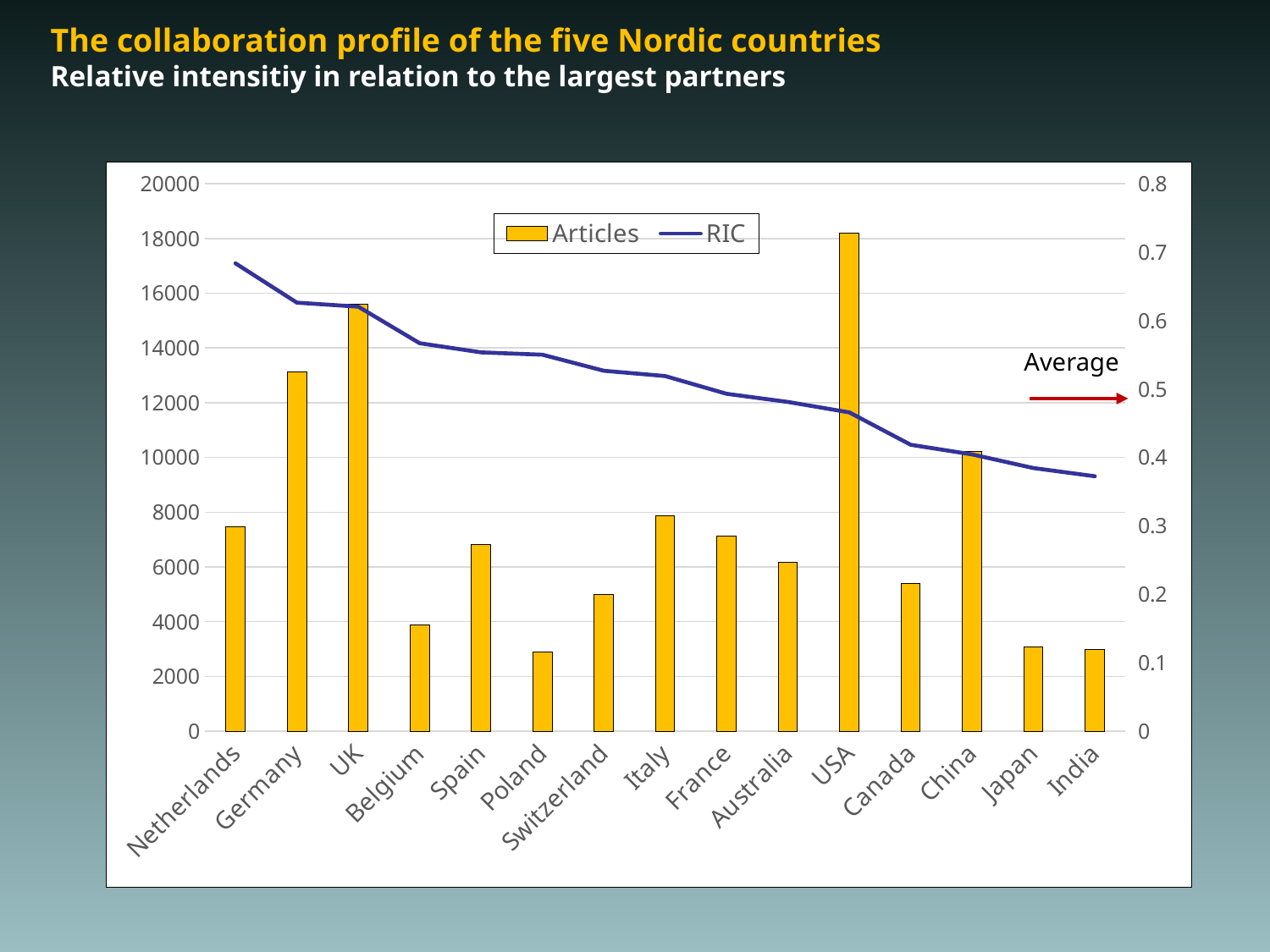
Which country has the highest number of Articles? USA How many series does the chart's legend list? 2 Is the Articles value for the Netherlands greater or less than 8000? less Is the Articles value for Canada greater or less than 6000? less Is the RIC value for the Netherlands greater or less than 0.6? greater What kind of chart is shown on the slide? bar chart with a line What value on the right axis does the 'Average' arrow point to? 0.5 Does the RIC line rise or fall from Netherlands to India along the x axis? fall How many countries are shown on the x axis of the chart? 15 What are the two entries in the chart's legend? Articles and RIC Which has more Articles, Germany or the UK? UK